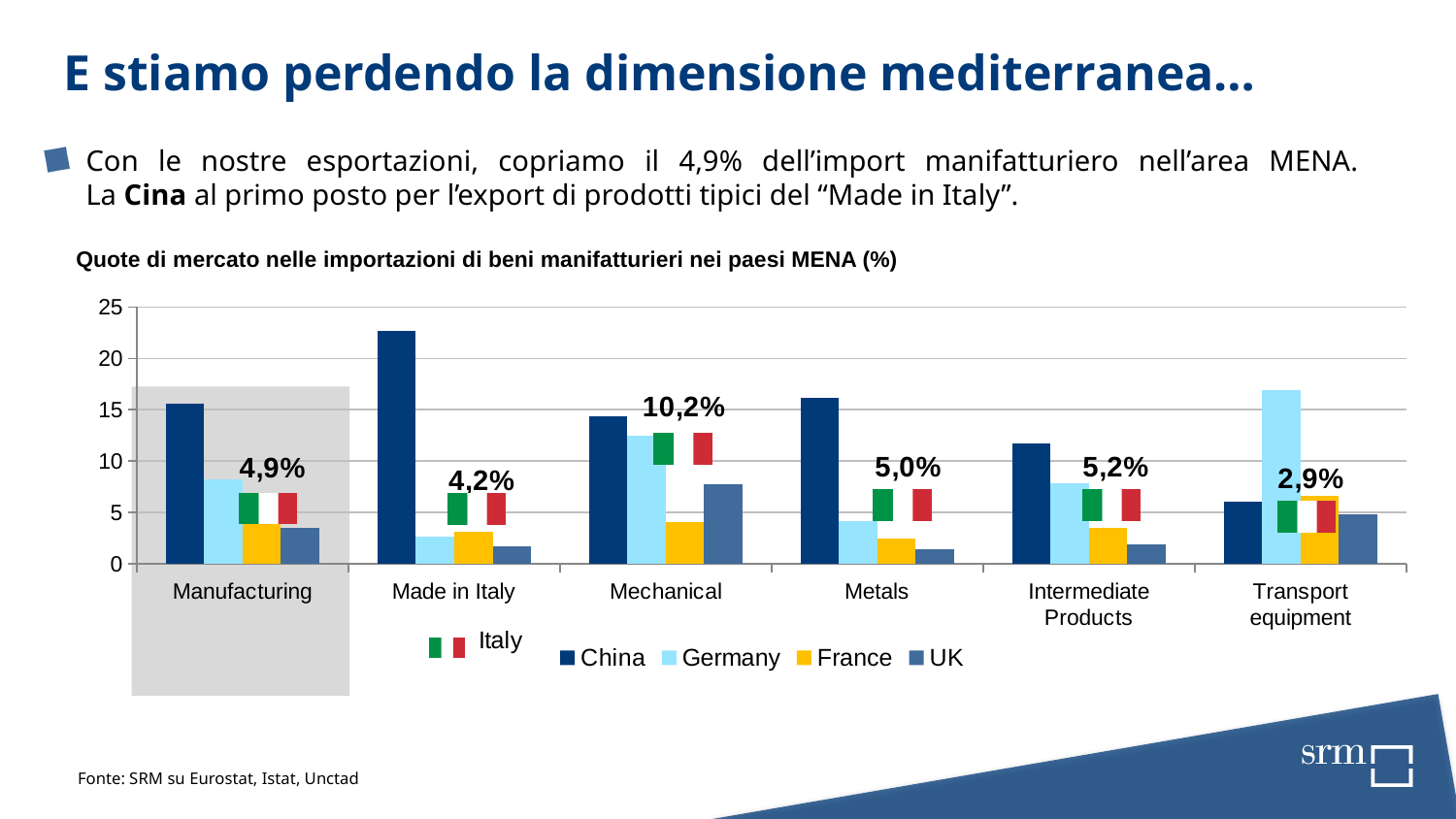
How many product categories are shown on the x axis of the chart? 6 What is Italy's market share in the Transport equipment category? 2,9% What is the difference between Italy's share in Mechanical and its share in Manufacturing? 5,3 In which category is Italy's labelled market share the highest? Mechanical What is Italy's market share in the Mechanical category? 10,2% Is the value for Germany in the Mechanical category greater or less than 10? greater Excluding the separate Italy flag marker, how many series does the chart's legend list? 4 Is the value for UK in the Made in Italy category greater or less than 5? less In the Transport equipment category, which is larger: the China bar or the Germany bar? Germany Is the value for China in the Made in Italy category greater or less than 20? greater In which category is Italy's labelled market share the lowest? Transport equipment What kind of chart is shown on the slide? bar chart